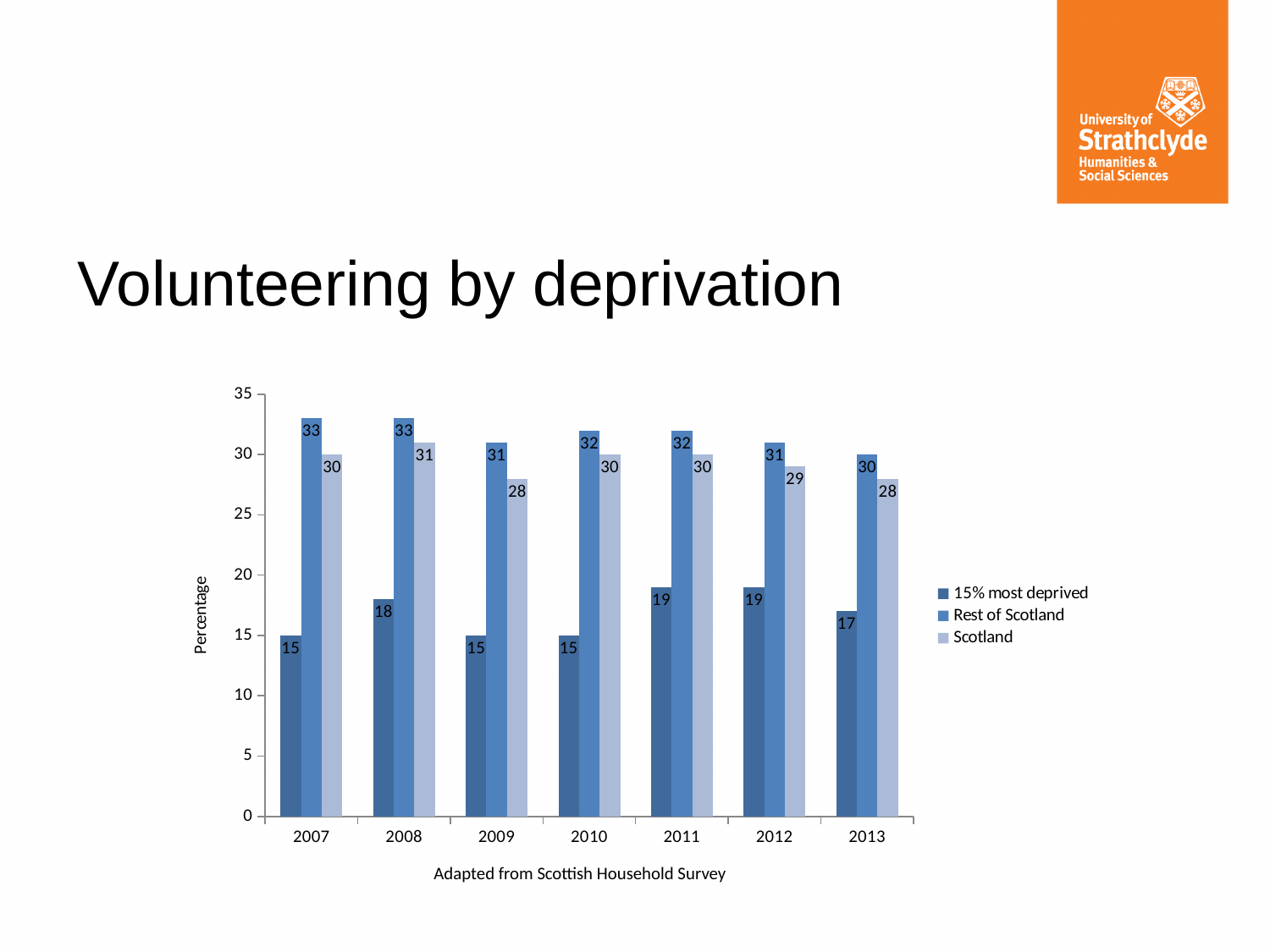
What is the difference between Rest of Scotland and 15% most deprived in 2007? 18 In which year is the value for Scotland lowest? 2009 and 2013 What is the label on the y axis of the chart? Percentage Does the value for Rest of Scotland rise or fall from 2008 to 2009? Fall What is the value for 15% most deprived in 2008? 18 What kind of chart is shown on the slide? Bar chart How many years are shown on the x axis? 7 What is the value for Rest of Scotland in 2011? 32 Which is larger in 2012: Rest of Scotland or Scotland? Rest of Scotland What is the value for Scotland in 2013? 28 In which year is the value for 15% most deprived highest? 2011 and 2012 How many series does the legend list? 3